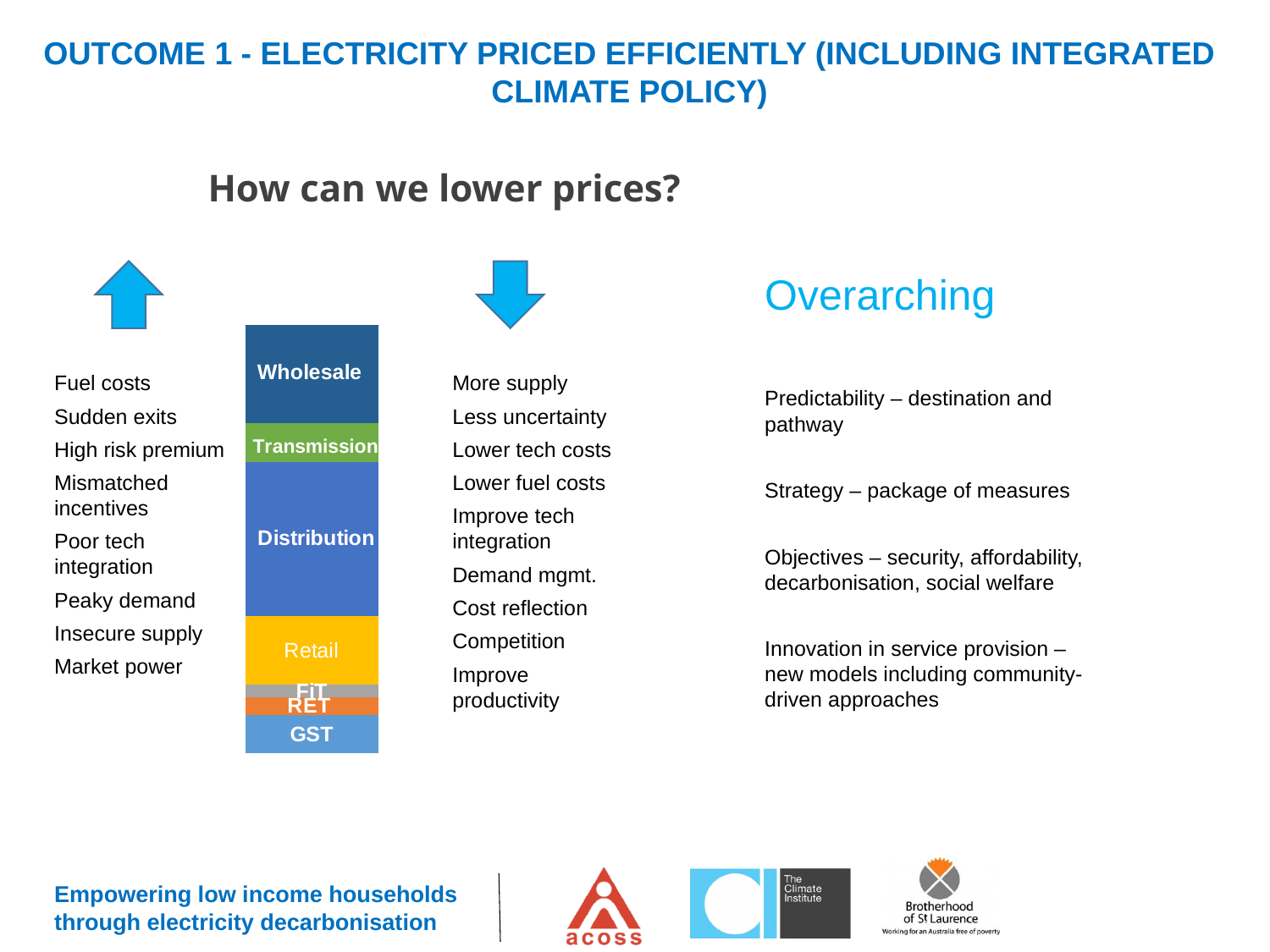
Which is larger in the stacked bar, the Retail segment or the GST segment? Retail Which is larger in the stacked bar, the Wholesale segment or the Transmission segment? Wholesale Which is larger in the stacked bar, the Distribution segment or the Wholesale segment? Distribution How many segments make up the stacked bar on the slide? 7 Which segment of the stacked bar is the largest? Distribution Which segment is at the top of the stacked bar? Wholesale What kind of chart is shown on the slide? Stacked bar chart What colour is the Retail segment of the stacked bar? Yellow